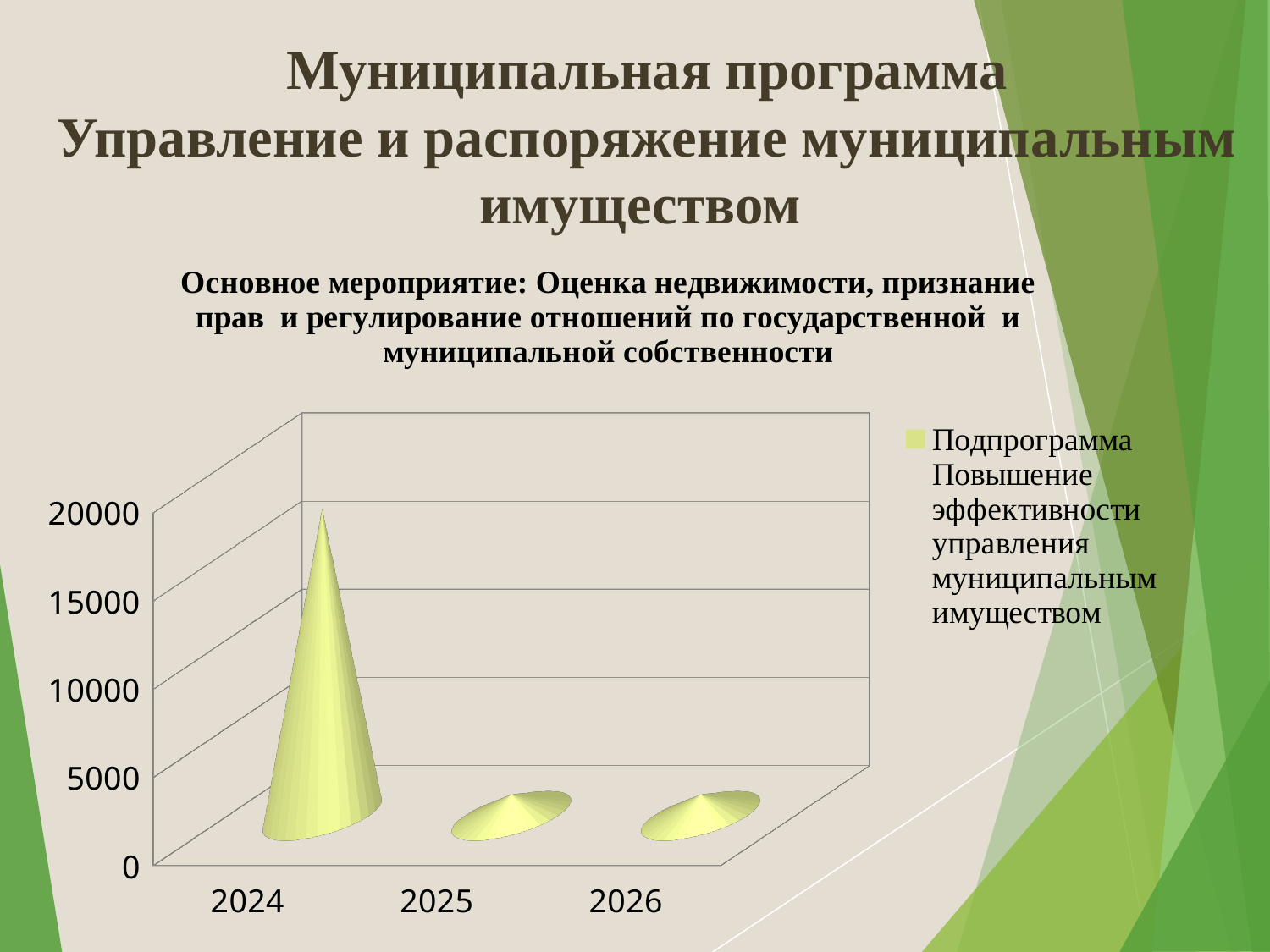
Is the value for 2026 greater or less than 5000? less What is the name of the series listed in the chart legend? Подпрограмма Повышение эффективности управления муниципальным имуществом Is the value for 2025 greater or less than 5000? less How many categories are shown on the x axis of the chart? 3 Is the value for 2024 greater or less than 10000? greater Which is larger, the value for 2024 or the value for 2026? 2024 How many series does the chart legend list? 1 What is the title of the chart? Основное мероприятие: Оценка недвижимости, признание прав и регулирование отношений по государственной и муниципальной собственности Which year has the highest value in the chart? 2024 Do the values rise or fall from 2024 to 2025? fall What kind of chart is shown on the slide? bar chart